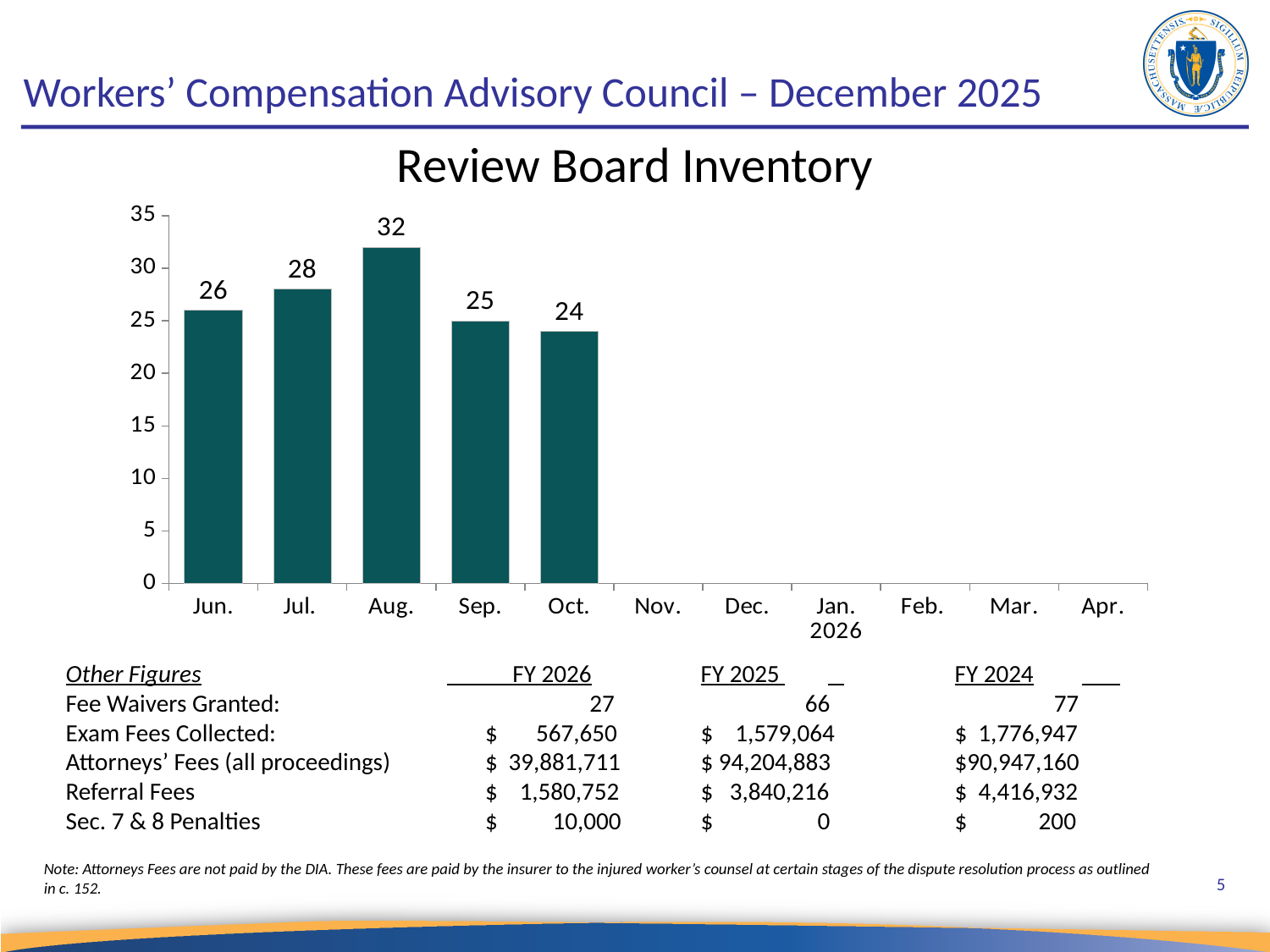
Which month has the highest Review Board Inventory? Aug. How many months have a plotted bar in the Review Board Inventory chart? 5 What is the Review Board Inventory value for Oct.? 24 Is the Review Board Inventory value for Aug. greater or less than 30? greater What is the Review Board Inventory value for Aug.? 32 Which is larger, the Review Board Inventory for Jul. or for Sep.? Jul. What is the title of the chart on the slide? Review Board Inventory What is the difference between the Review Board Inventory for Aug. and Sep.? 7 Which month with a plotted bar has the lowest Review Board Inventory? Oct. Does the Review Board Inventory rise or fall from Aug. to Oct.? fall What kind of chart is the Review Board Inventory chart? bar chart What is the Review Board Inventory value for Jun.? 26